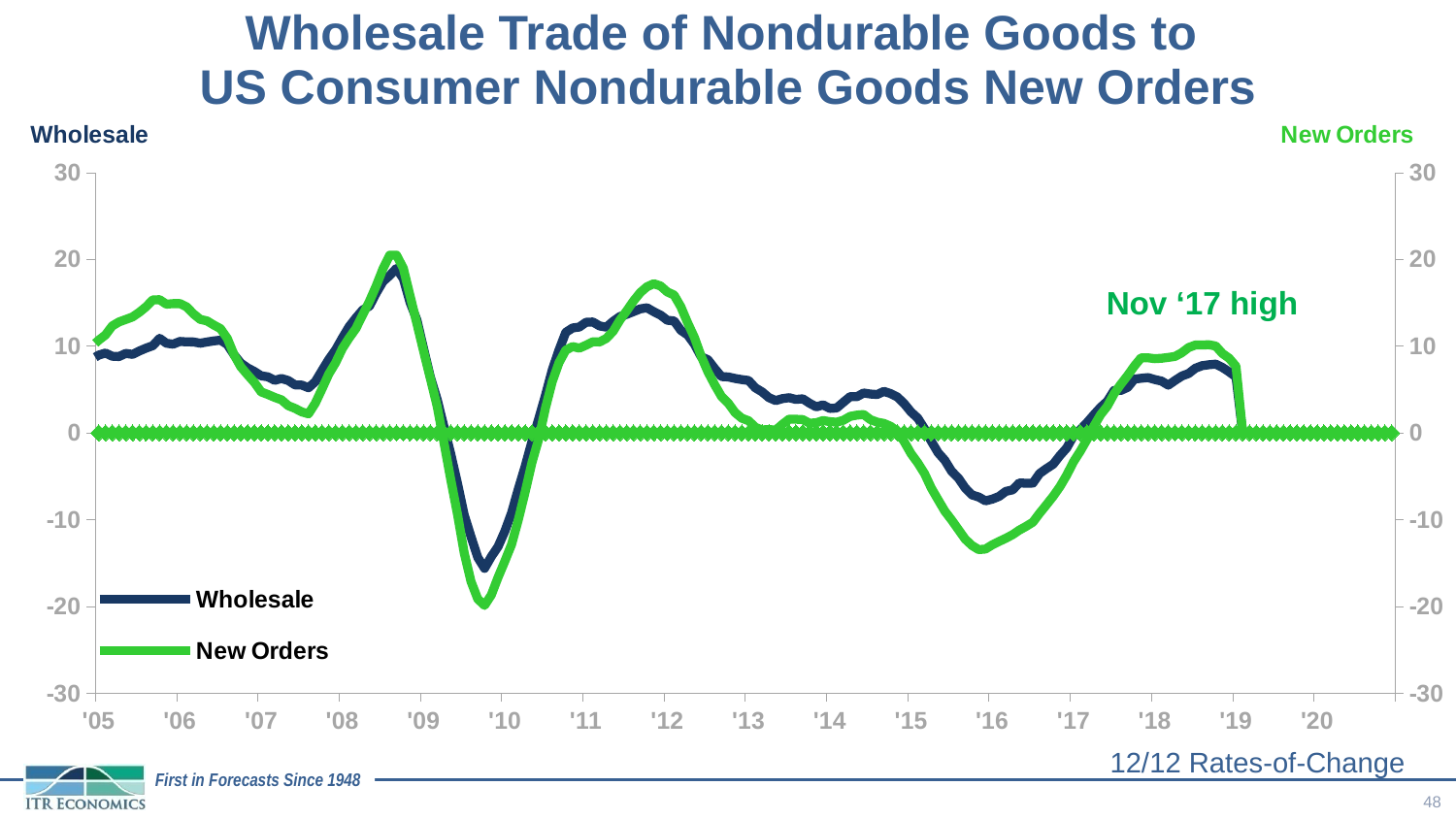
Do the New Orders values rise or fall between '16 and '18? rise At '10, which series has the lower value, Wholesale or New Orders? New Orders Is the value for Wholesale at '16 greater or less than -10? greater What kind of chart is shown on the slide? Line chart Is the value for New Orders at '10 greater or less than -10? less Do the Wholesale values rise or fall between '09 and '10? fall How many series does the legend list? 2 Which series is drawn in green? New Orders At '06, which series has the higher value, Wholesale or New Orders? New Orders Is the value for New Orders at '16 greater or less than -10? less What annotation is printed near the right side of the chart above the lines? Nov '17 high